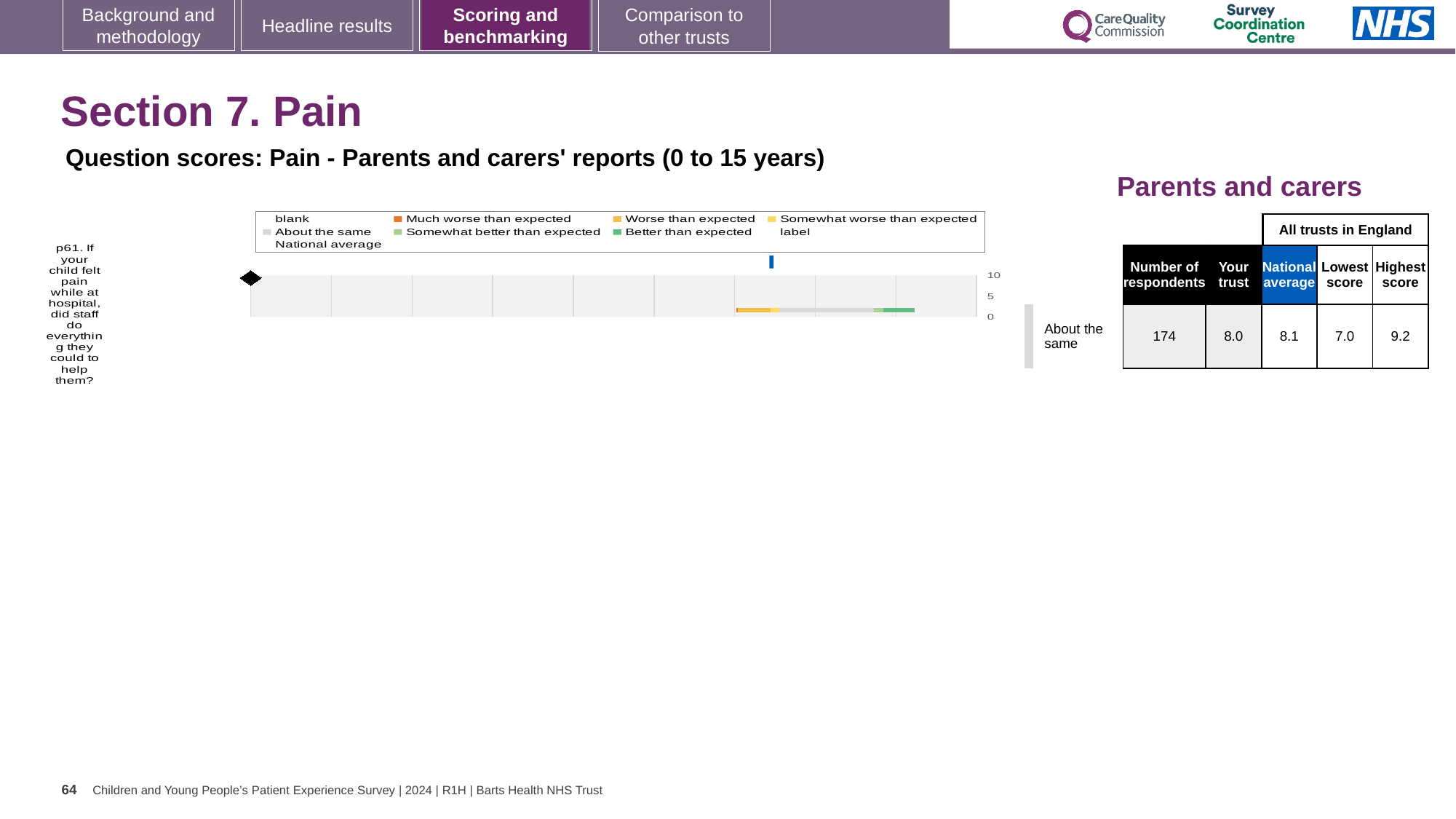
How many entries does the chart legend list? 9 What kind of chart is shown on the slide for question p61? bar chart In the table beside the chart, what is the 'Your trust' score for p61? 8.0 How many survey questions are plotted in the chart? 1 In the table beside the chart, what is the national average score for p61? 8.1 In the table beside the chart, what is the highest score among all trusts in England for p61? 9.2 In the table beside the chart, what is the lowest score among all trusts in England for p61? 7.0 Which is larger for p61, the 'Your trust' score or the national average? National average What colour does the legend use for 'Much worse than expected'? orange What is the difference between the highest score and the lowest score shown in the table for p61? 2.2 According to the table beside the chart, which benchmark category does the trust's result for p61 fall into? About the same In the table beside the chart, how many respondents answered p61? 174